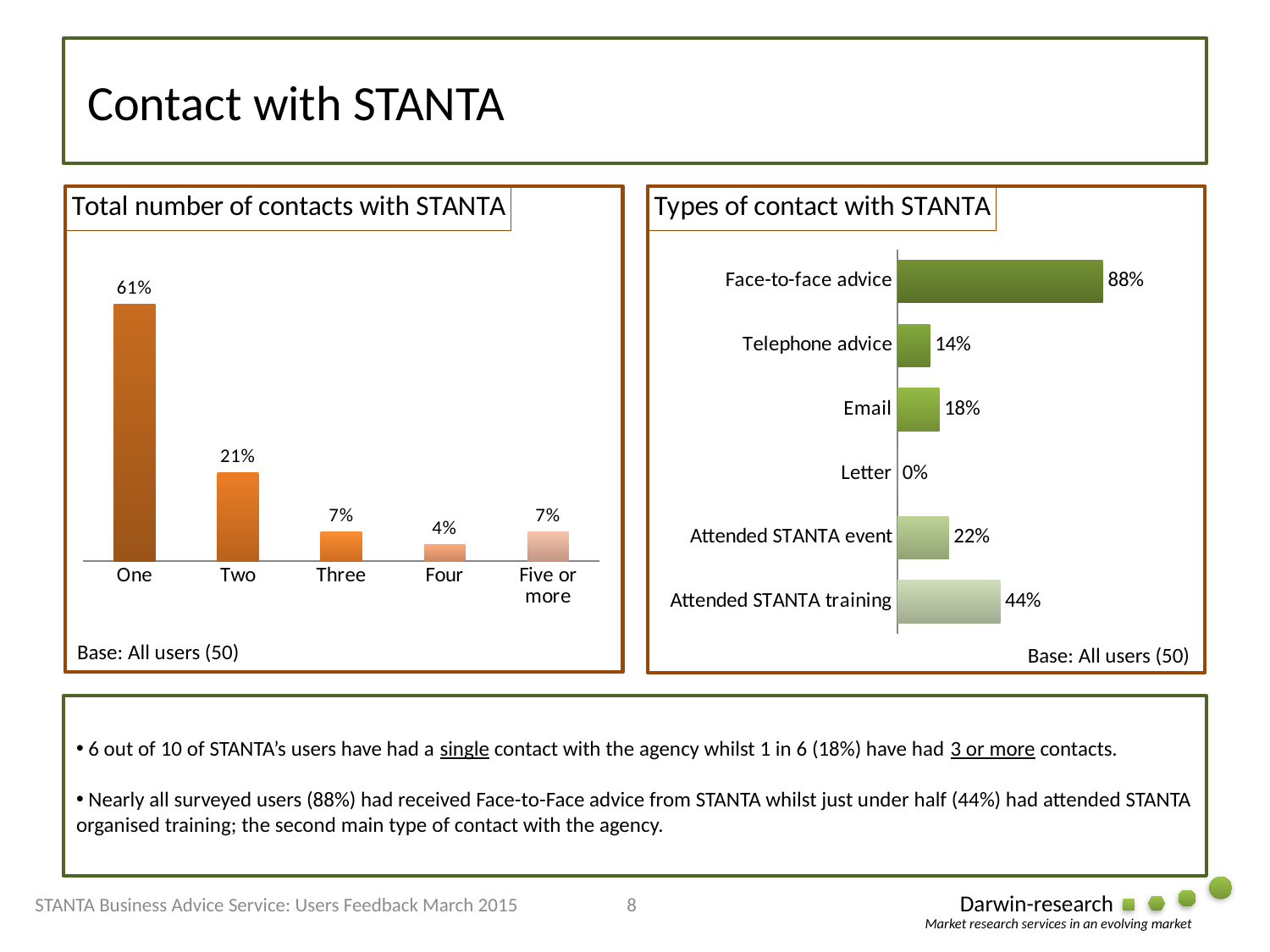
In the 'Total number of contacts with STANTA' chart, how many categories are shown? 5 In the 'Types of contact with STANTA' chart, what is the difference between Face-to-face advice and Attended STANTA training? 44% In the 'Types of contact with STANTA' chart, how many categories are shown? 6 What type of chart is the 'Types of contact with STANTA' chart? Bar chart In the 'Types of contact with STANTA' chart, what is the value for Attended STANTA training? 44% In the 'Total number of contacts with STANTA' chart, what is the value for One? 61% In the 'Total number of contacts with STANTA' chart, which category has the lowest value? Four In the 'Total number of contacts with STANTA' chart, what is the value for Five or more? 7% In the 'Total number of contacts with STANTA' chart, what is the difference between the values for One and Two? 40% In the 'Types of contact with STANTA' chart, which is larger: Email or Telephone advice? Email In the 'Types of contact with STANTA' chart, which category has the highest value? Face-to-face advice In the 'Types of contact with STANTA' chart, which category has the lowest value? Letter